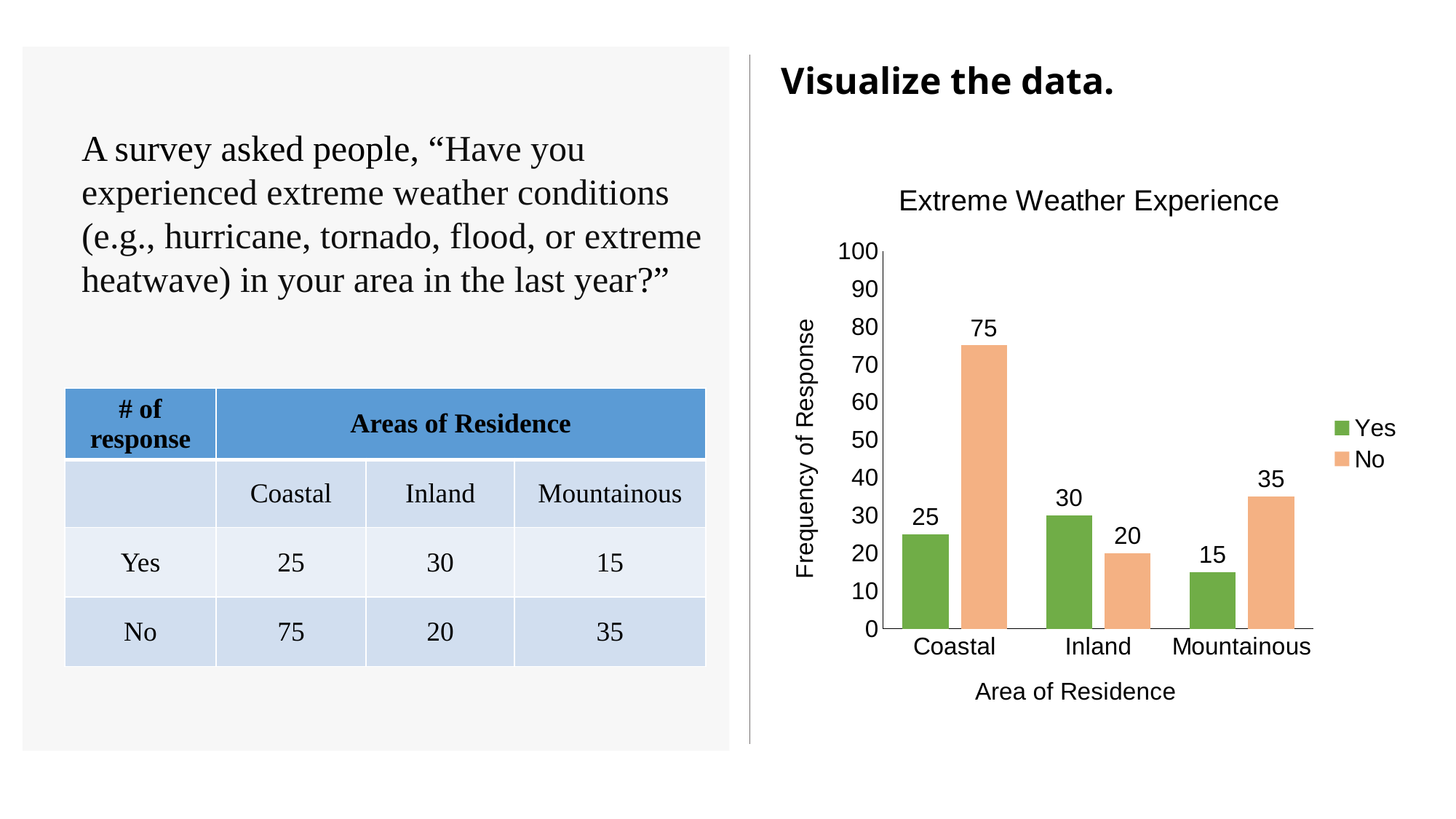
What is the title of the chart? Extreme Weather Experience What kind of chart is shown? bar chart How many areas of residence are shown on the x axis? 3 How many series does the legend list? 2 What is the value for No in the Mountainous area? 35 Which area has the highest No value? Coastal What is the value for Yes in the Coastal area? 25 What is the value for No in the Inland area? 20 What is the difference between the No and Yes values for Coastal? 50 Is the No value for Coastal greater or less than 70? greater Which is larger for Inland, the Yes value or the No value? Yes Which area has the lowest Yes value? Mountainous